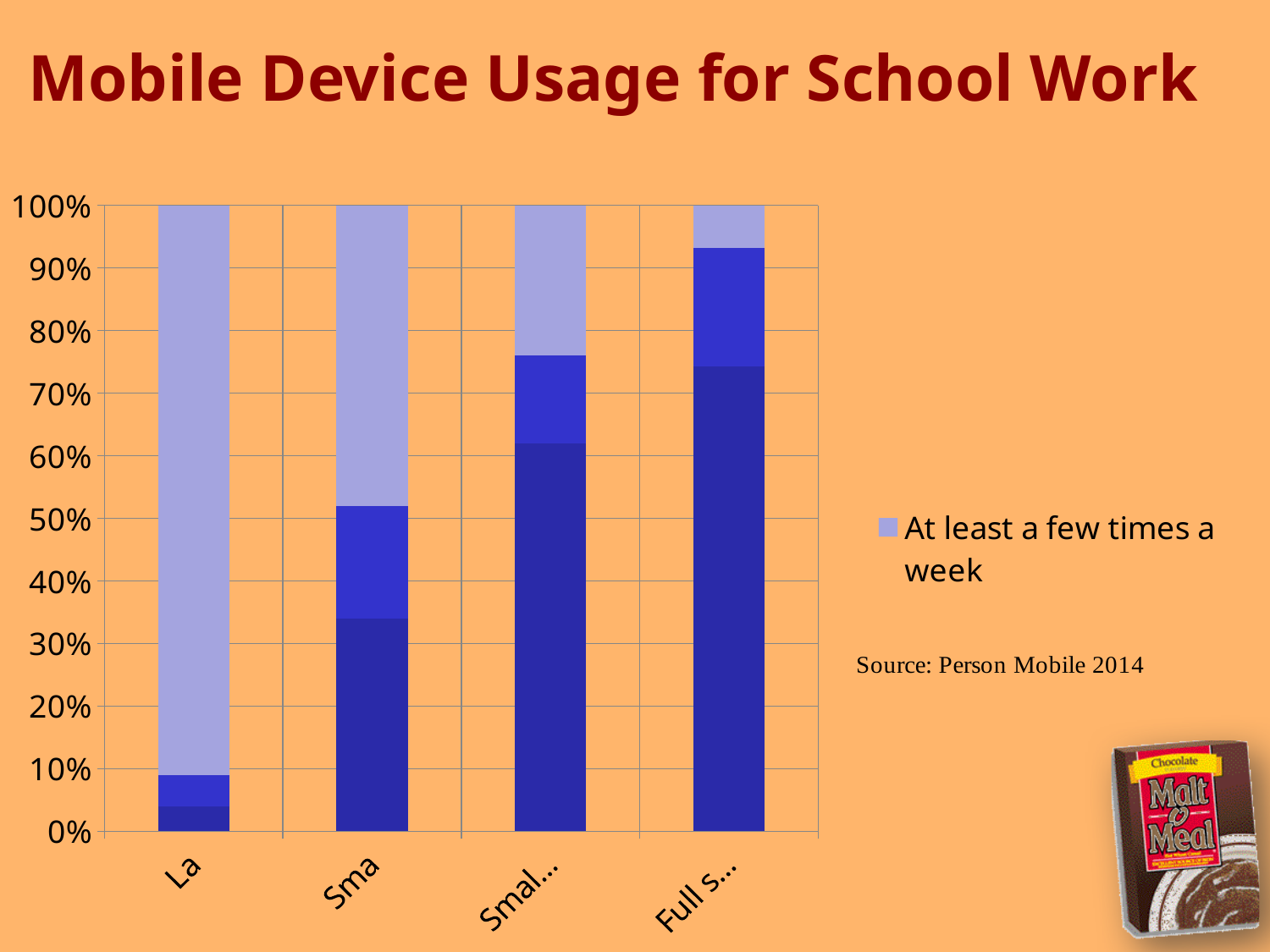
How many bars (categories) are plotted in the chart? 4 What is the legend entry shown for the light purple segments? At least a few times a week Is the top of the dark blue segment in the second bar greater or less than 40%? less What is the title of the chart on the slide? Mobile Device Usage for School Work Which bar has the largest light purple (At least a few times a week) segment? the first (leftmost) bar Is the top of the dark blue segment in the first (leftmost) bar greater or less than 10%? less What kind of chart is shown on the slide? bar chart Does the dark blue segment rise or fall across the bars from left to right? rises Is the top of the dark blue segment in the third bar greater or less than 50%? greater What total does each stacked bar reach on the vertical axis? 100% How many series does the chart's legend list? 1